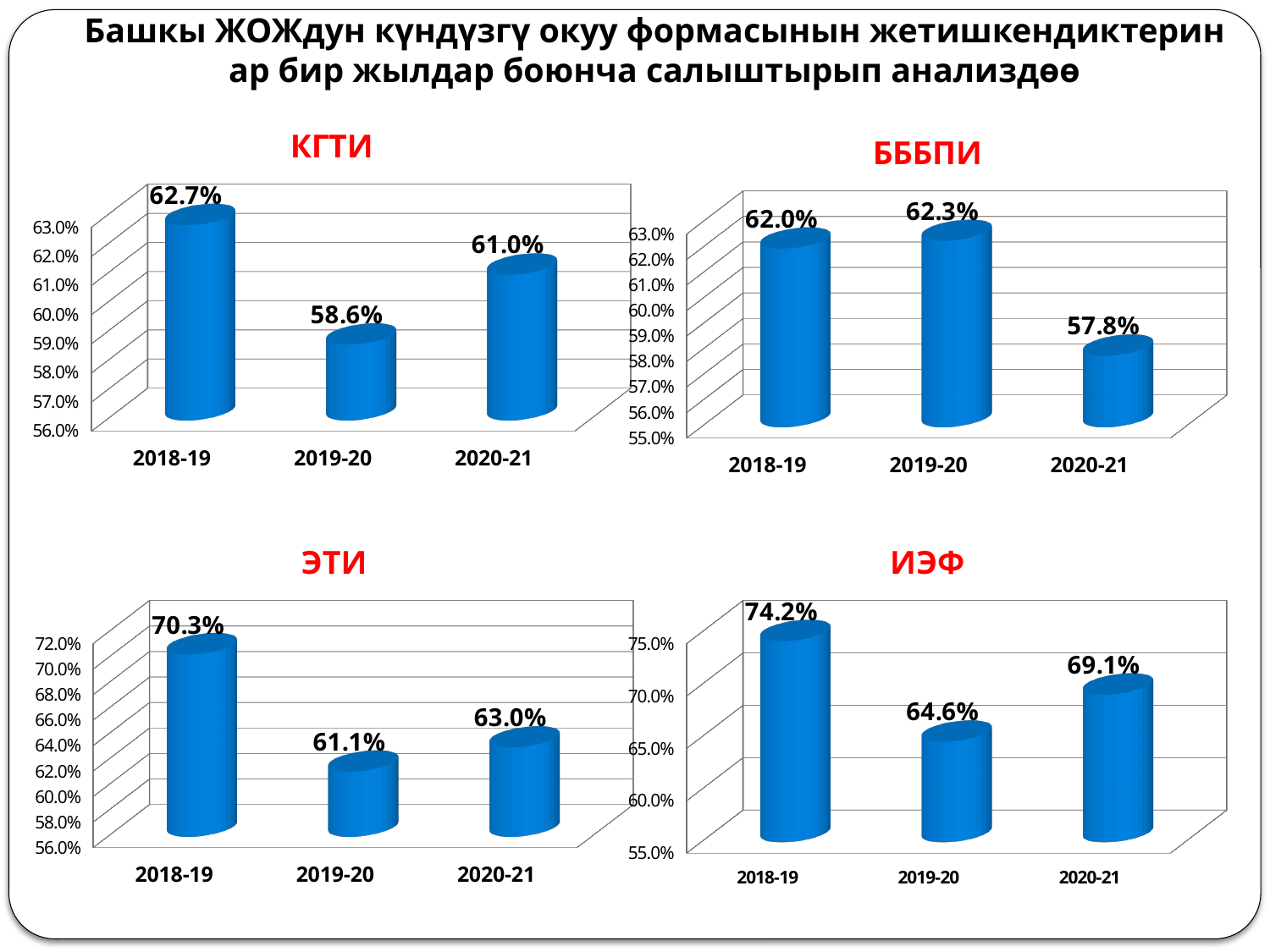
In the БББПИ chart, what is the value for 2020-21? 57.8% In the ИЭФ chart, what is the value for 2018-19? 74.2% How many charts are on the slide? 4 How many categories are shown on the x axis of the ИЭФ chart? 3 In the ЭТИ chart, which is larger, the value for 2018-19 or 2020-21? 2018-19 In the ИЭФ chart, what is the difference between the 2018-19 and 2019-20 values? 9.6% In the ЭТИ chart, what is the value for 2019-20? 61.1% In the БББПИ chart, what is the difference between the 2019-20 and 2020-21 values? 4.5% In the БББПИ chart, which year has the highest value? 2019-20 In the КГТИ chart, what is the value for 2018-19? 62.7% In the КГТИ chart, which year has the lowest value? 2019-20 What kind of chart is the КГТИ chart? Bar chart